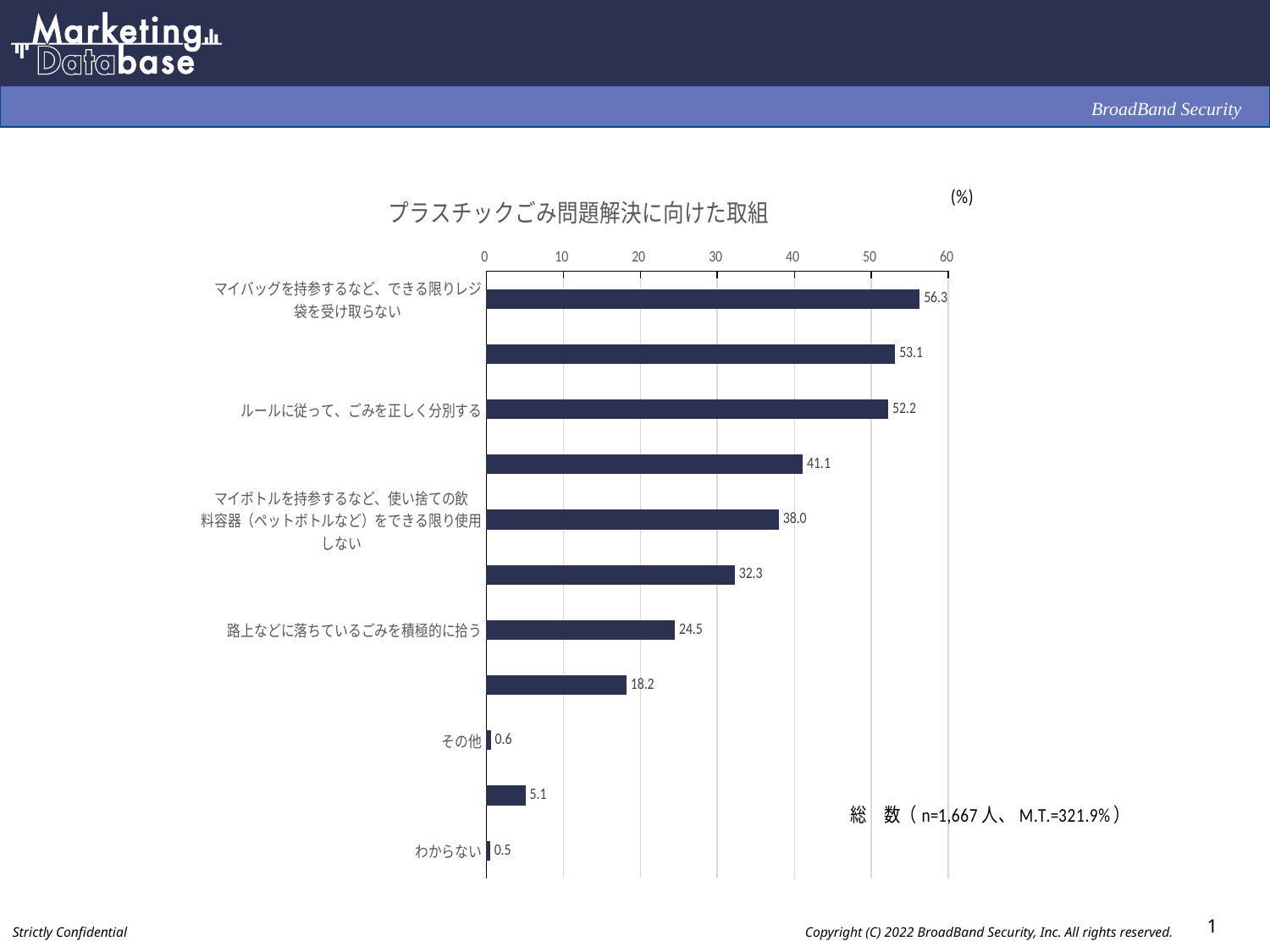
What is the value for 「ルールに従って、ごみを正しく分別する」? 52.2 What is the value for 「わからない」? 0.5 What is the difference between the values for 「マイバッグを持参するなど、できる限りレジ袋を受け取らない」 and 「ルールに従って、ごみを正しく分別する」? 4.1 What kind of chart is shown on the slide? Bar chart Which is larger: the value for 「マイボトルを持参するなど、使い捨ての飲料容器（ペットボトルなど）をできる限り使用しない」 or for 「路上などに落ちているごみを積極的に拾う」? マイボトルを持参するなど、使い捨ての飲料容器（ペットボトルなど）をできる限り使用しない What is the value for 「マイボトルを持参するなど、使い捨ての飲料容器（ペットボトルなど）をできる限り使用しない」? 38.0 What is the value for 「マイバッグを持参するなど、できる限りレジ袋を受け取らない」? 56.3 What is the value for 「路上などに落ちているごみを積極的に拾う」? 24.5 What is the value for 「その他」? 0.6 Which category has the highest value? マイバッグを持参するなど、できる限りレジ袋を受け取らない How many bars are plotted in the chart? 11 What is the title of the chart? プラスチックごみ問題解決に向けた取組